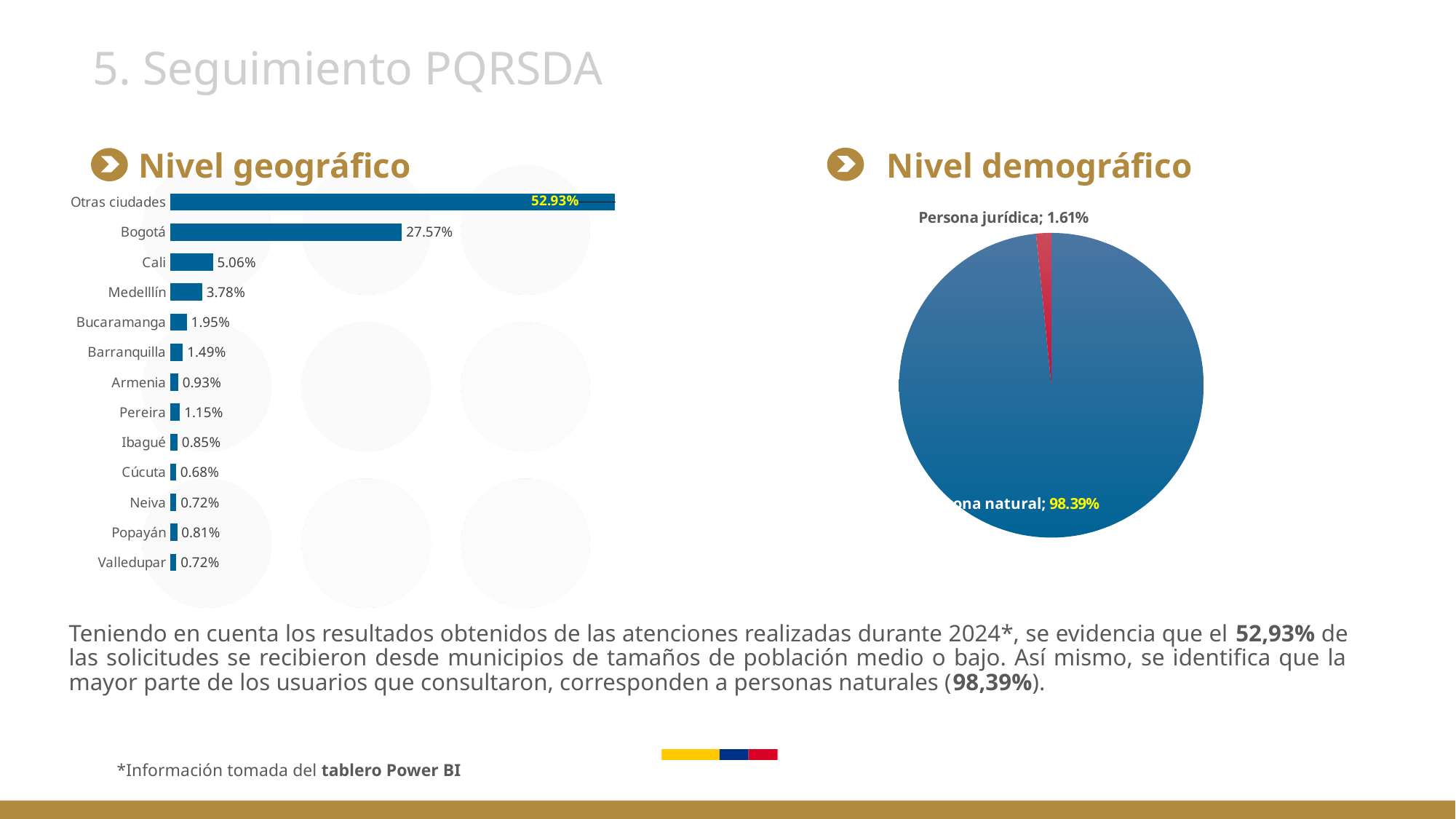
In the 'Nivel geográfico' chart, which is larger, Medellín or Cali? Cali In the 'Nivel geográfico' chart, what is the value for Bogotá? 27.57% What kind of chart is the 'Nivel demográfico' chart? Pie chart In the 'Nivel geográfico' chart, what is the value for Cali? 5.06% In the 'Nivel geográfico' chart, what is the value for Bucaramanga? 1.95% In the 'Nivel geográfico' chart, which category has the highest value? Otras ciudades In the 'Nivel geográfico' chart, what is the difference between Otras ciudades and Bogotá? 25.36% What kind of chart is the 'Nivel geográfico' chart? Bar chart In the 'Nivel demográfico' chart, what share does Persona natural have? 98.39% In the 'Nivel demográfico' chart, what share does Persona jurídica have? 1.61% In the 'Nivel geográfico' chart, which category has the lowest value? Cúcuta In the 'Nivel geográfico' chart, how many categories are shown? 13